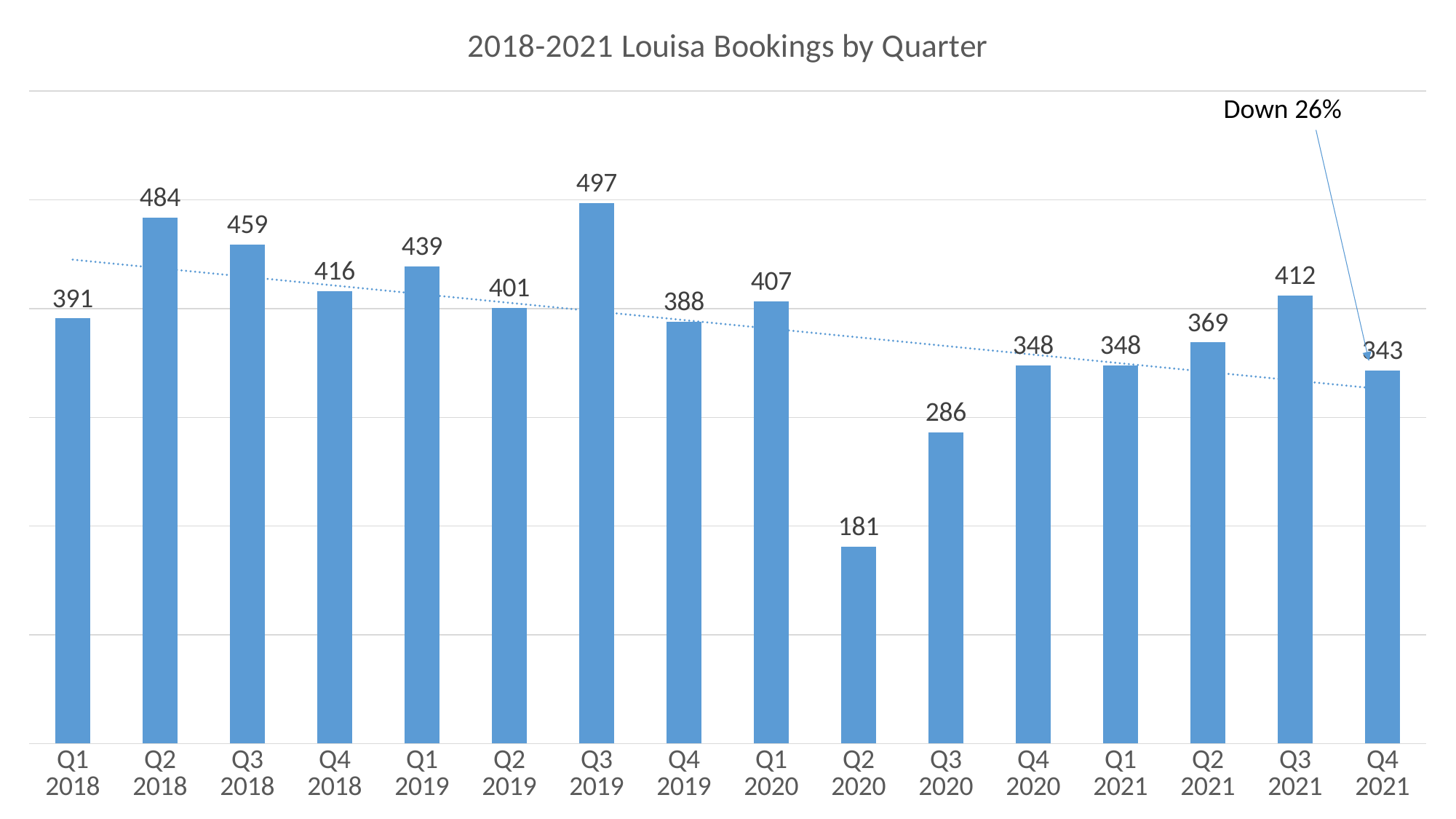
Does the dotted trend line rise or fall from left to right? Fall What is the title of the chart? 2018-2021 Louisa Bookings by Quarter Which quarter has the highest bookings? Q3 2019 What is the value for Q4 2021? 343 Which quarter has the lowest bookings? Q2 2020 Which is larger, Q3 2021 or Q2 2021? Q3 2021 What kind of chart is this? Bar chart What is the value for Q3 2019? 497 How many quarters are shown on the x axis? 16 What is the difference between Q3 2019 and Q2 2020? 316 What is the value for Q2 2020? 181 What is the difference between Q2 2018 and Q4 2021? 141